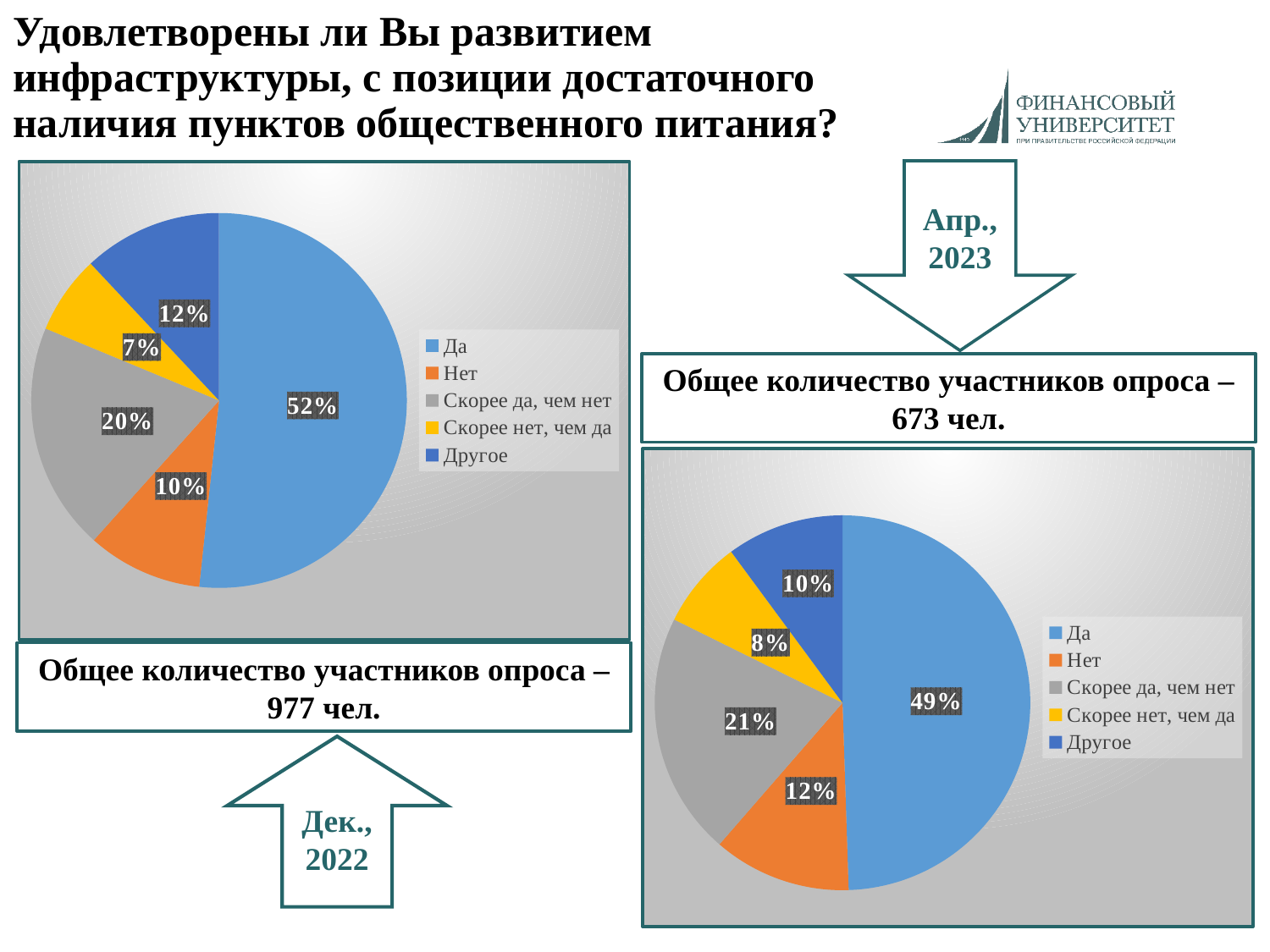
In the left pie chart (Dec. 2022), which category has the largest slice? Да In the right pie chart (Apr. 2023), what share is labelled for "Нет"? 12% In the left pie chart (Dec. 2022), what share is labelled for "Скорее нет, чем да"? 7% In the left pie chart (Dec. 2022), what is the difference between the shares for "Скорее да, чем нет" and "Нет"? 10% In the right pie chart (Apr. 2023), what share is labelled for "Да"? 49% How many slices does the right pie chart (Apr. 2023) have? 5 In the left pie chart (Dec. 2022), what share is labelled for "Да"? 52% How many entries does the legend of the left pie chart (Dec. 2022) list? 5 In the left pie chart (Dec. 2022), what colour is the slice for "Скорее нет, чем да"? Yellow In the right pie chart (Apr. 2023), which category has the smallest slice? Скорее нет, чем да What type of chart is shown on the left side of the slide? Pie chart In the right pie chart (Apr. 2023), which is larger: the share for "Скорее да, чем нет" or the share for "Другое"? Скорее да, чем нет